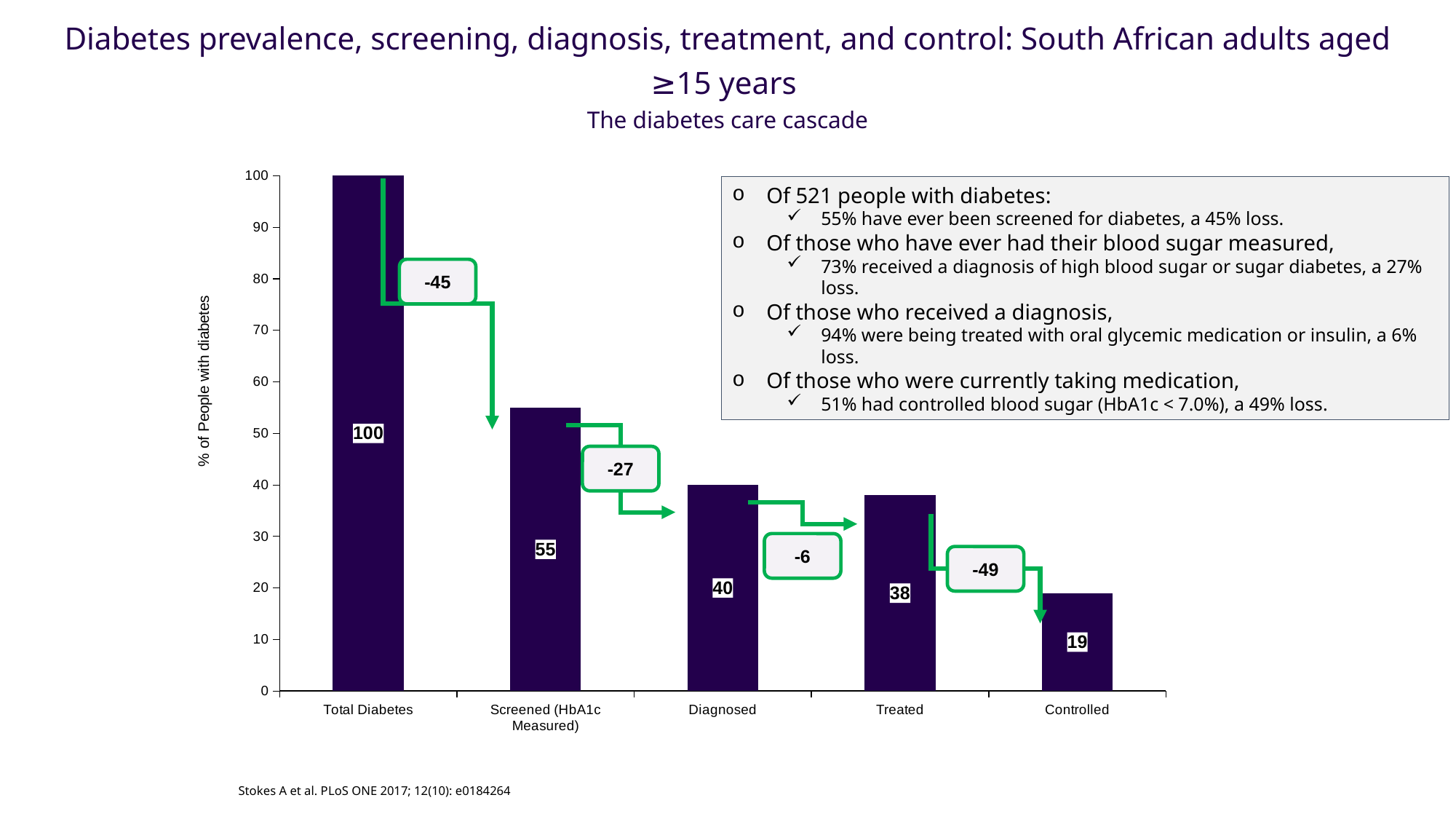
What is the value for Controlled? 19 Which is larger, the value for Screened (HbA1c Measured) or the value for Diagnosed? Screened (HbA1c Measured) Which category has the highest value? Total Diabetes What is the difference between the values for Diagnosed and Controlled? 21 Do the values rise or fall from Total Diabetes to Controlled? Fall How many categories are shown on the x axis? 5 What loss is shown in the callout between Treated and Controlled? -49 What is the y-axis label of the chart? % of People with diabetes What is the value for Treated? 38 Which category has the lowest value? Controlled What kind of chart is shown? Bar chart What is the value for Screened (HbA1c Measured)? 55